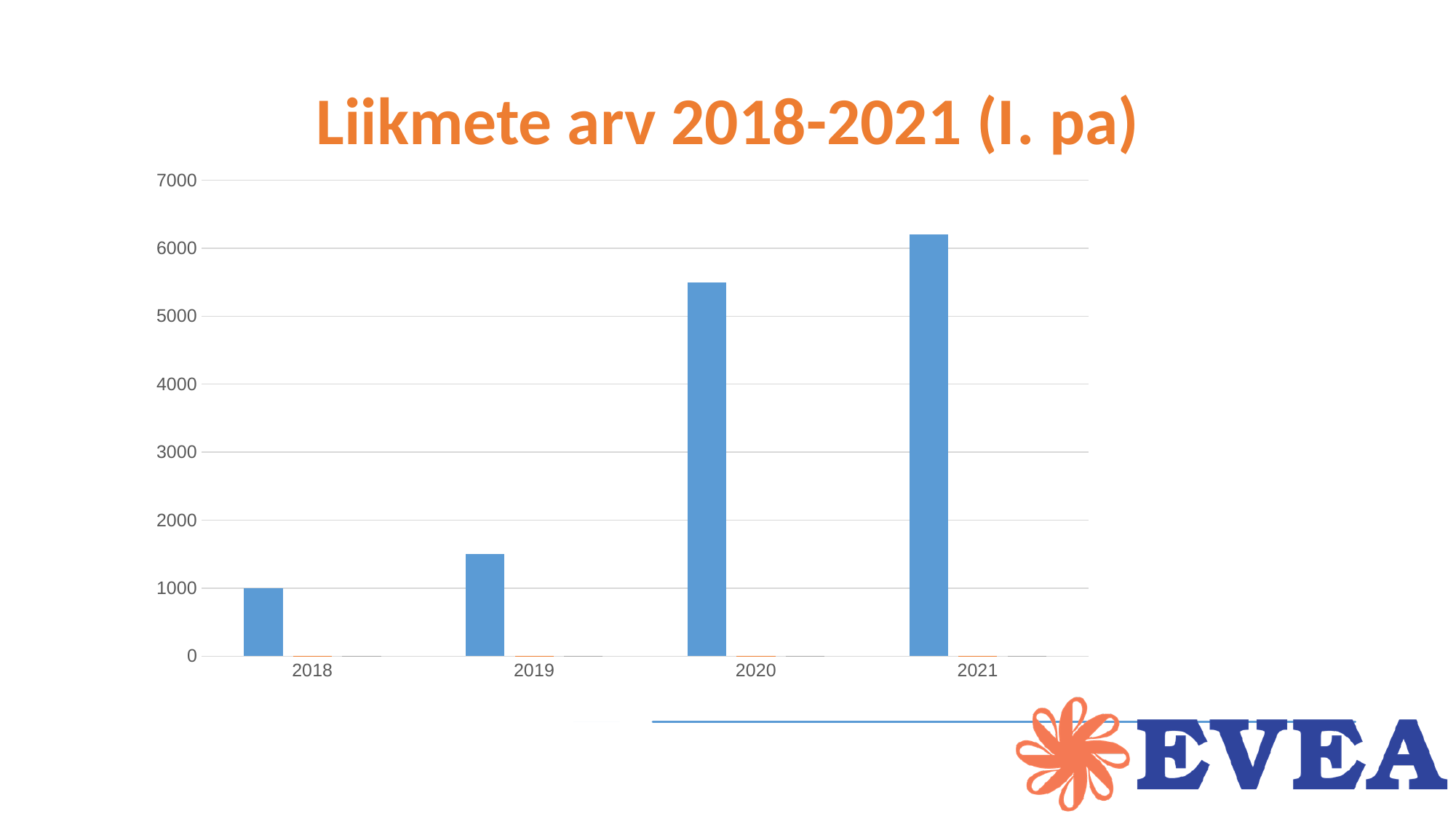
Which year has the larger value, 2020 or 2021? 2021 How many years are shown on the x axis of the chart? 4 What is the value for 2018? 1000 Which year has the highest bar? 2021 Is the value for 2021 greater or less than 6000? greater Which year has the larger value, 2018 or 2019? 2019 Which year has the lowest bar? 2018 Is the value for 2019 greater or less than 2000? less What is the title of the chart? Liikmete arv 2018-2021 (I. pa) What kind of chart is shown on the slide? bar chart Is the value for 2020 greater or less than 5000? greater Do the values rise or fall from 2018 to 2021? rise